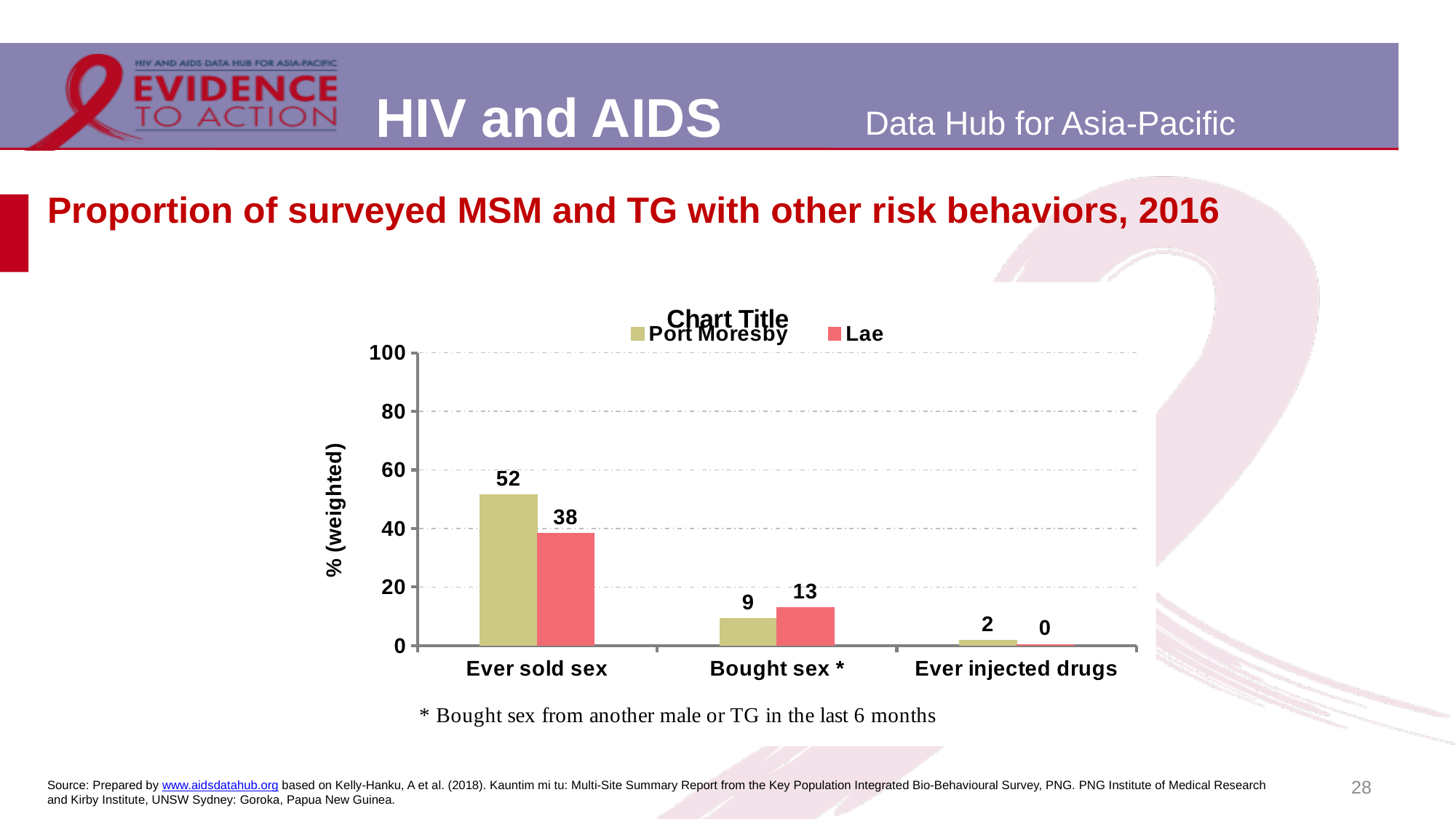
What is the difference between the Port Moresby and Lae values for 'Ever sold sex'? 14 Is the value for Port Moresby in 'Ever sold sex' greater or less than 40? greater What kind of chart is shown on the slide? Bar chart What is the value for Port Moresby in the 'Ever sold sex' category? 52 Which category has the lowest value for Lae? Ever injected drugs Which category has the highest value for Port Moresby? Ever sold sex What is the value for Lae in the 'Ever injected drugs' category? 0 What is the label of the y axis? % (weighted) How many series does the legend list? 2 What is the value for Lae in the 'Bought sex *' category? 13 For 'Bought sex *', which series has the larger value, Port Moresby or Lae? Lae How many categories are shown on the x axis? 3